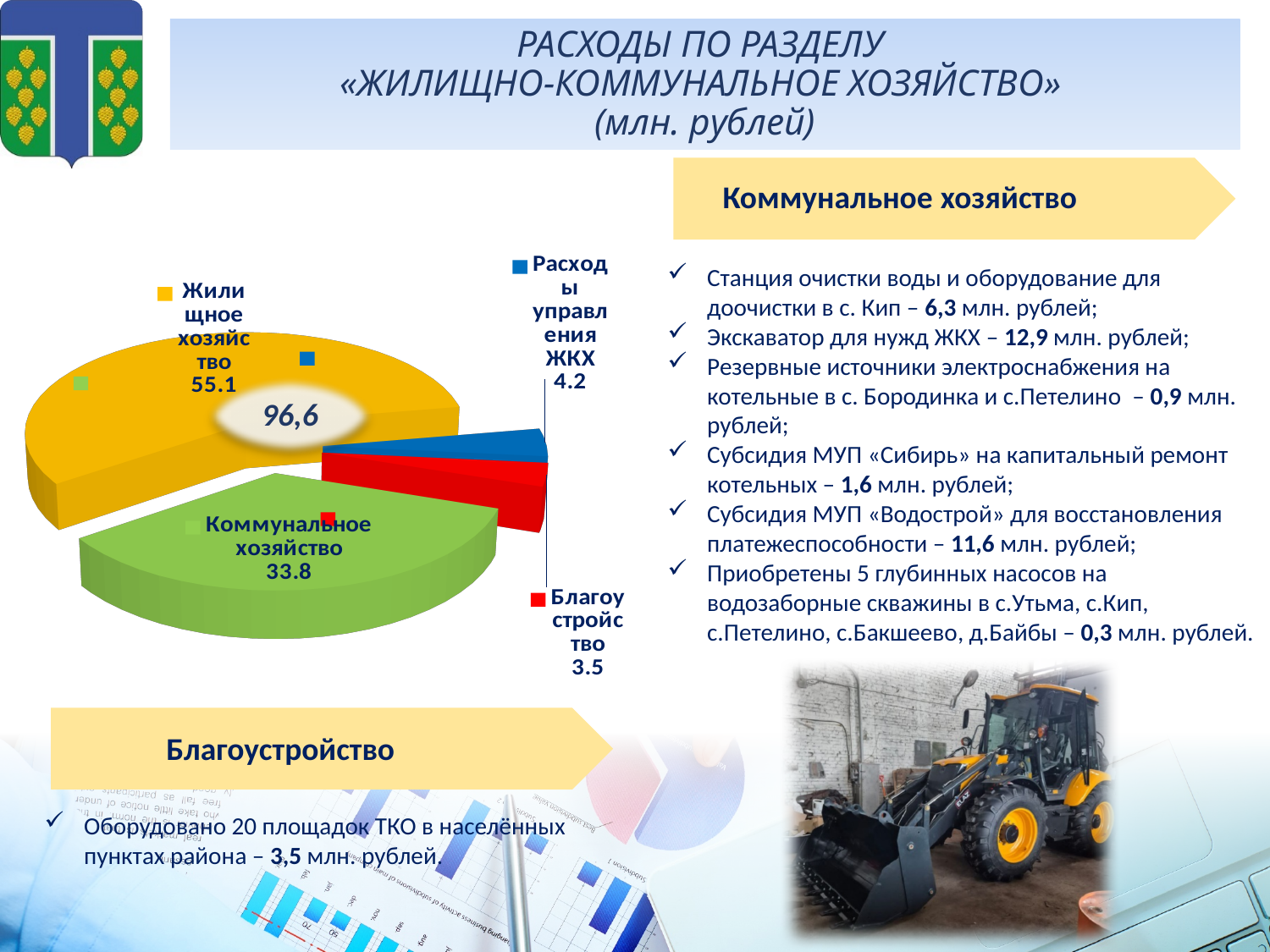
What is the value for Коммунальное хозяйство in the pie chart? 33.8 Which is larger: Расходы управления ЖКХ or Благоустройство? Расходы управления ЖКХ What is the value for Расходы управления ЖКХ in the pie chart? 4.2 What colour is the Коммунальное хозяйство slice in the pie chart? Green Which category has the smallest slice in the pie chart? Благоустройство What is the value for Жилищное хозяйство in the pie chart? 55.1 How many slices does the pie chart have? 4 Which category has the largest slice in the pie chart? Жилищное хозяйство What kind of chart is shown on the slide? Pie chart What total value is shown in the centre of the pie chart? 96,6 What is the difference between the values for Жилищное хозяйство and Коммунальное хозяйство? 21.3 What is the value for Благоустройство in the pie chart? 3.5